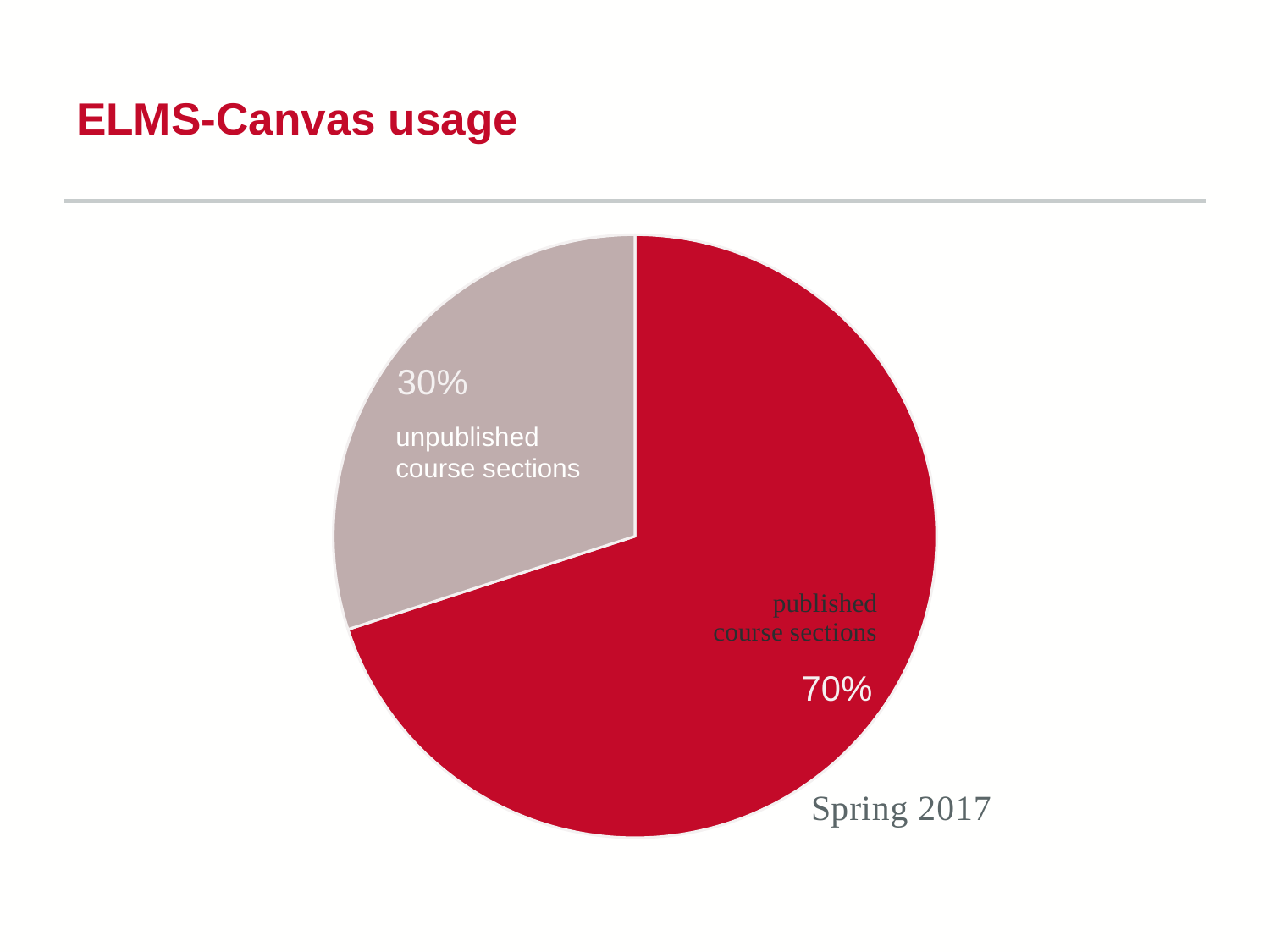
Which term does the pie chart refer to, according to the label below it? Spring 2017 Which slice of the pie is the largest? published course sections What kind of chart is shown on the slide? pie chart Which is larger, the published course sections slice or the unpublished course sections slice? published course sections Which slice of the pie is the smallest? unpublished course sections What is the title of the slide containing the pie chart? ELMS-Canvas usage How many slices does the pie chart have? 2 What is the difference in percentage points between the published and unpublished course sections slices? 40 What share of the pie is labelled unpublished course sections? 30% What share of the pie is labelled published course sections? 70%